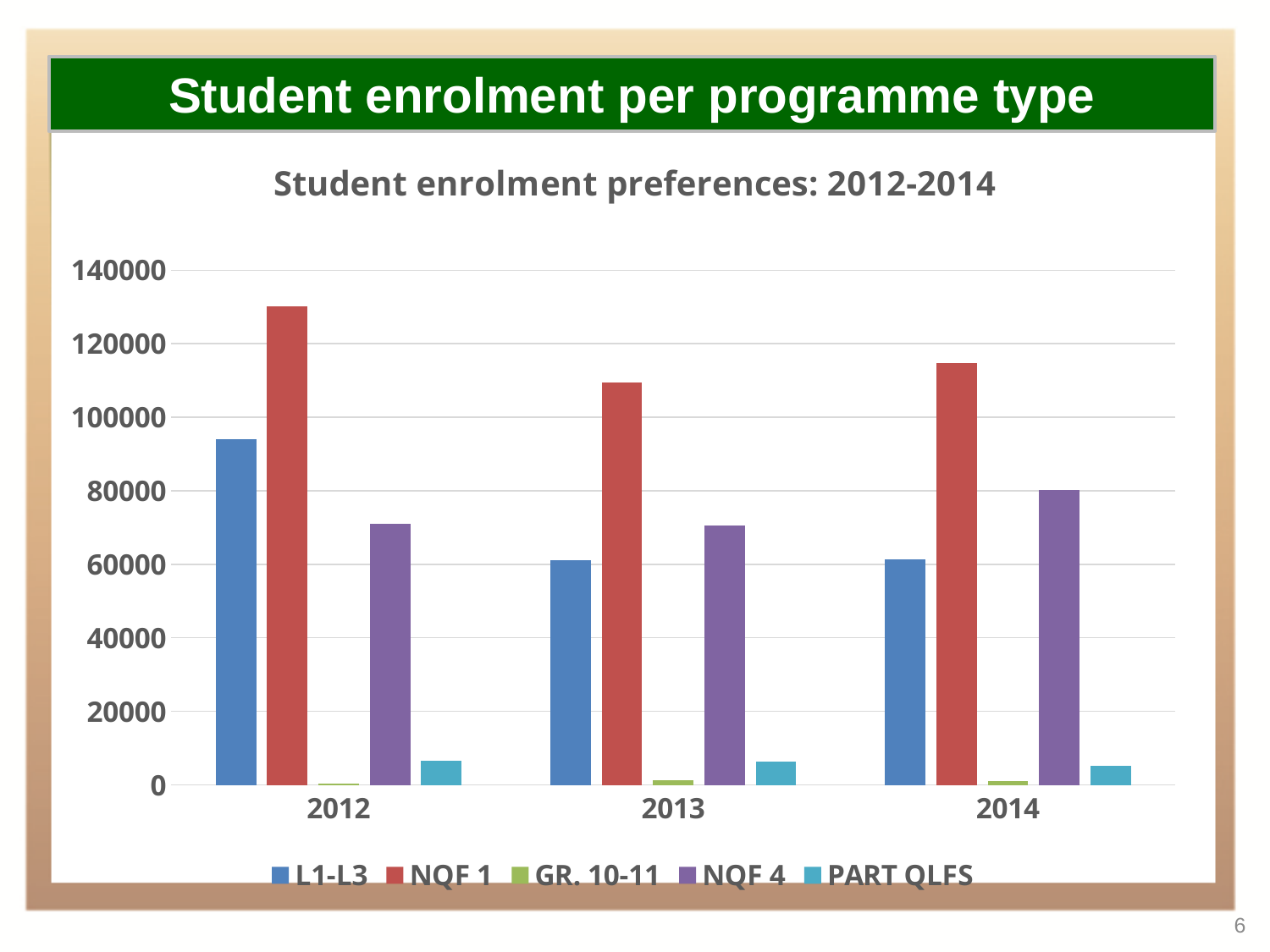
Is the value for NQF 1 in 2012 greater or less than 120000? greater Does the value for L1-L3 rise or fall from 2012 to 2013? fall What is the title of the chart? Student enrolment preferences: 2012-2014 Is the value for L1-L3 in 2012 greater or less than 100000? less Which programme type has the lowest enrolment in 2012? GR. 10-11 How many series does the legend list? 5 What kind of chart is shown on the slide? bar chart Which programme type has the highest enrolment in 2012? NQF 1 How many years are shown on the x axis? 3 Which is larger in 2012, L1-L3 or NQF 4? L1-L3 Is the value for L1-L3 in 2013 greater or less than 80000? less Which is larger, NQF 4 in 2012 or NQF 4 in 2014? NQF 4 in 2014